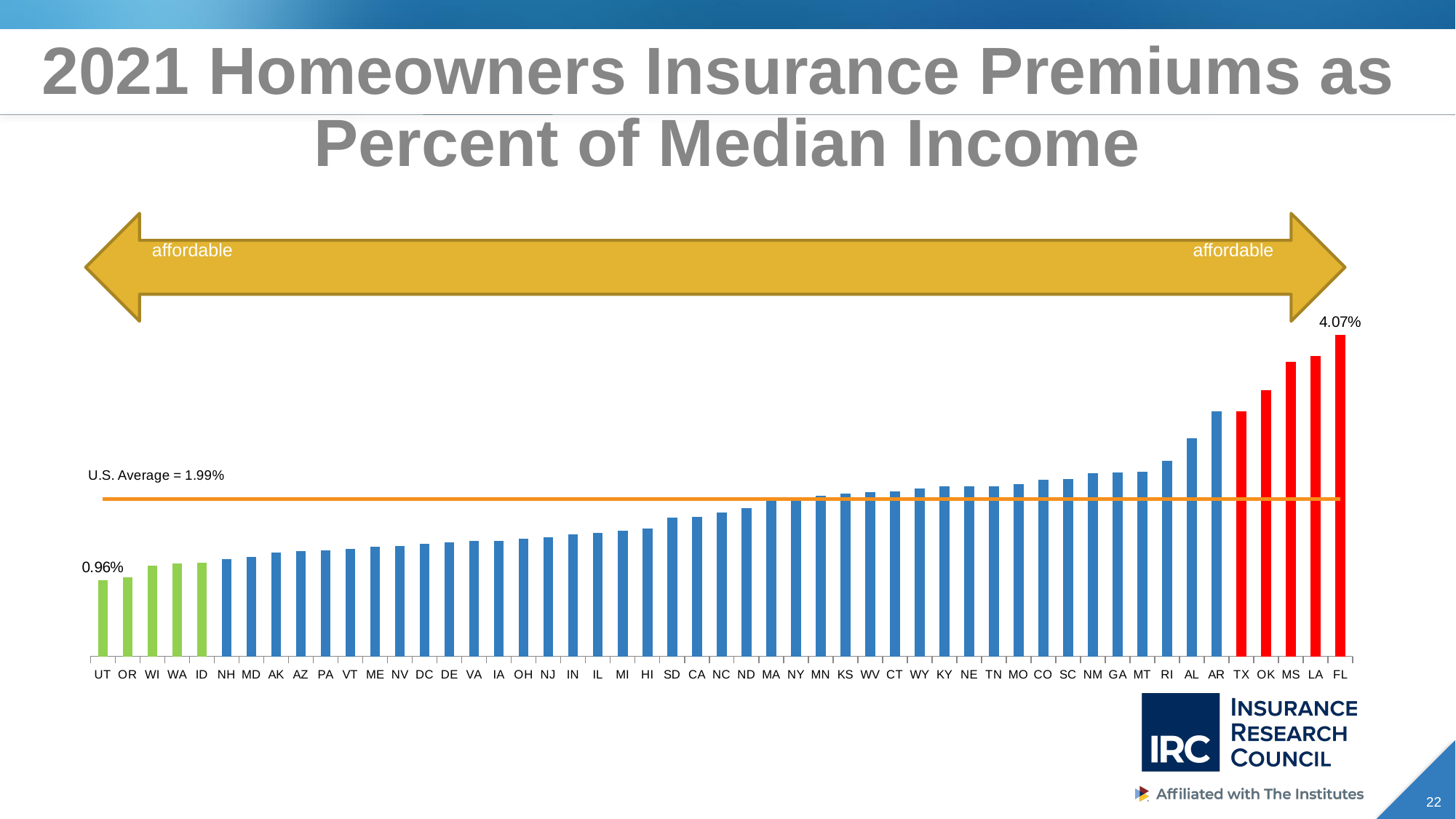
Which state has the highest homeowners insurance premium as a percent of median income? FL What kind of chart is shown on the slide? Bar chart What is the value shown for FL? 4.07% How many states (including DC) are plotted on the chart? 51 What is the value shown for UT? 0.96% Which has the larger value, NJ or TX? TX Which state has the lowest homeowners insurance premium as a percent of median income? UT How many bars are coloured green on the chart? 5 Do the values rise or fall moving from left to right along the x axis? Rise What is the difference between the values for FL and UT? 3.11 percentage points Which has the larger value, MS or AR? MS What is the U.S. average value marked by the horizontal line on the chart? 1.99%